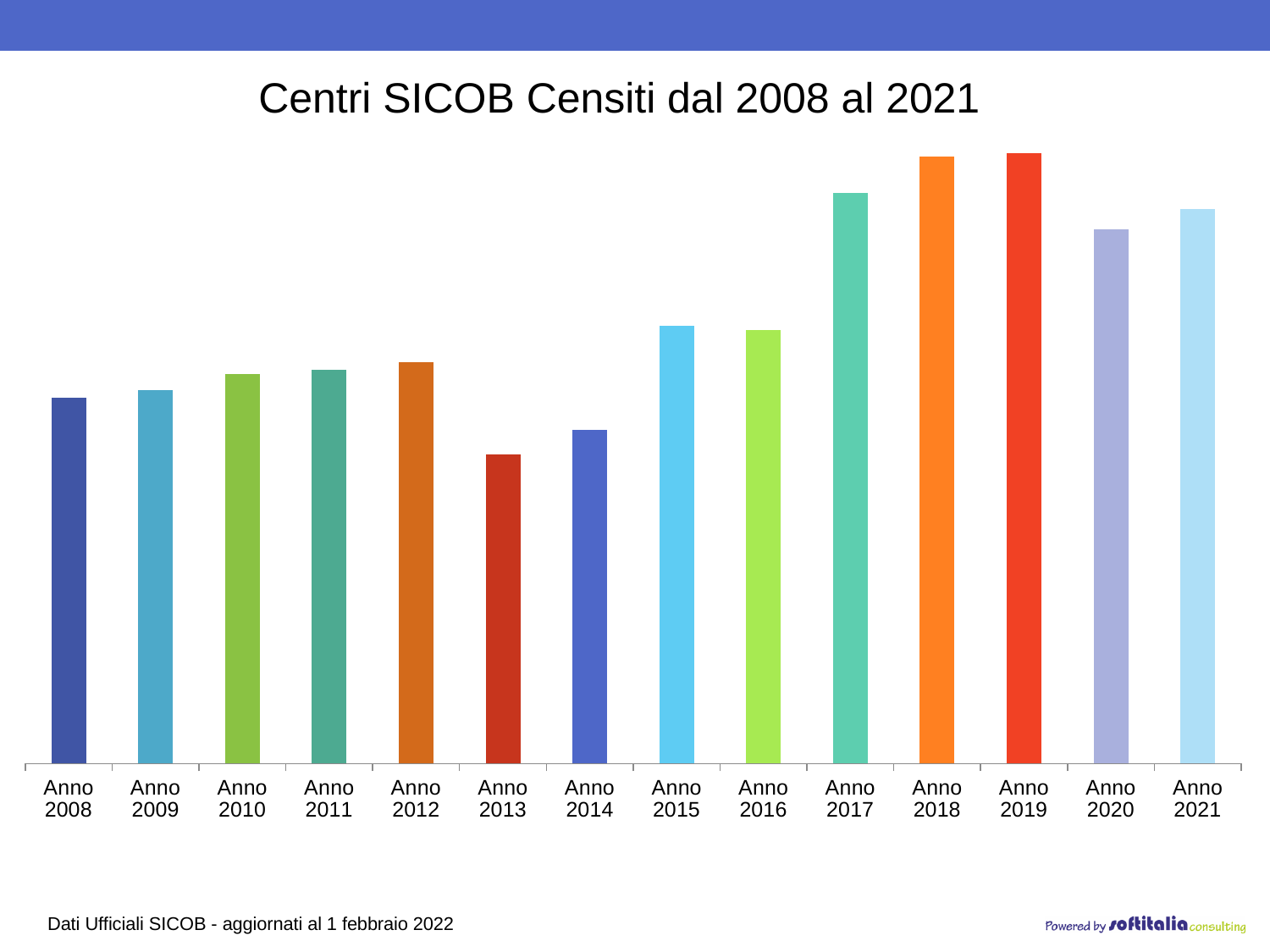
Is the bar for Anno 2021 higher or lower than the bar for Anno 2008? Higher Does the value rise or fall from Anno 2019 to Anno 2020? Fall Which year has the lowest bar in the chart? Anno 2013 Which bar is taller, Anno 2013 or Anno 2014? Anno 2014 What source note is printed at the bottom left of the slide? Dati Ufficiali SICOB - aggiornati al 1 febbraio 2022 Which bar is taller, Anno 2008 or Anno 2012? Anno 2012 Do the bars rise or fall from Anno 2008 to Anno 2012? Rise What is the title of the chart? Centri SICOB Censiti dal 2008 al 2021 How many years (bars) are shown in the chart? 14 What kind of chart is shown on the slide? Bar chart